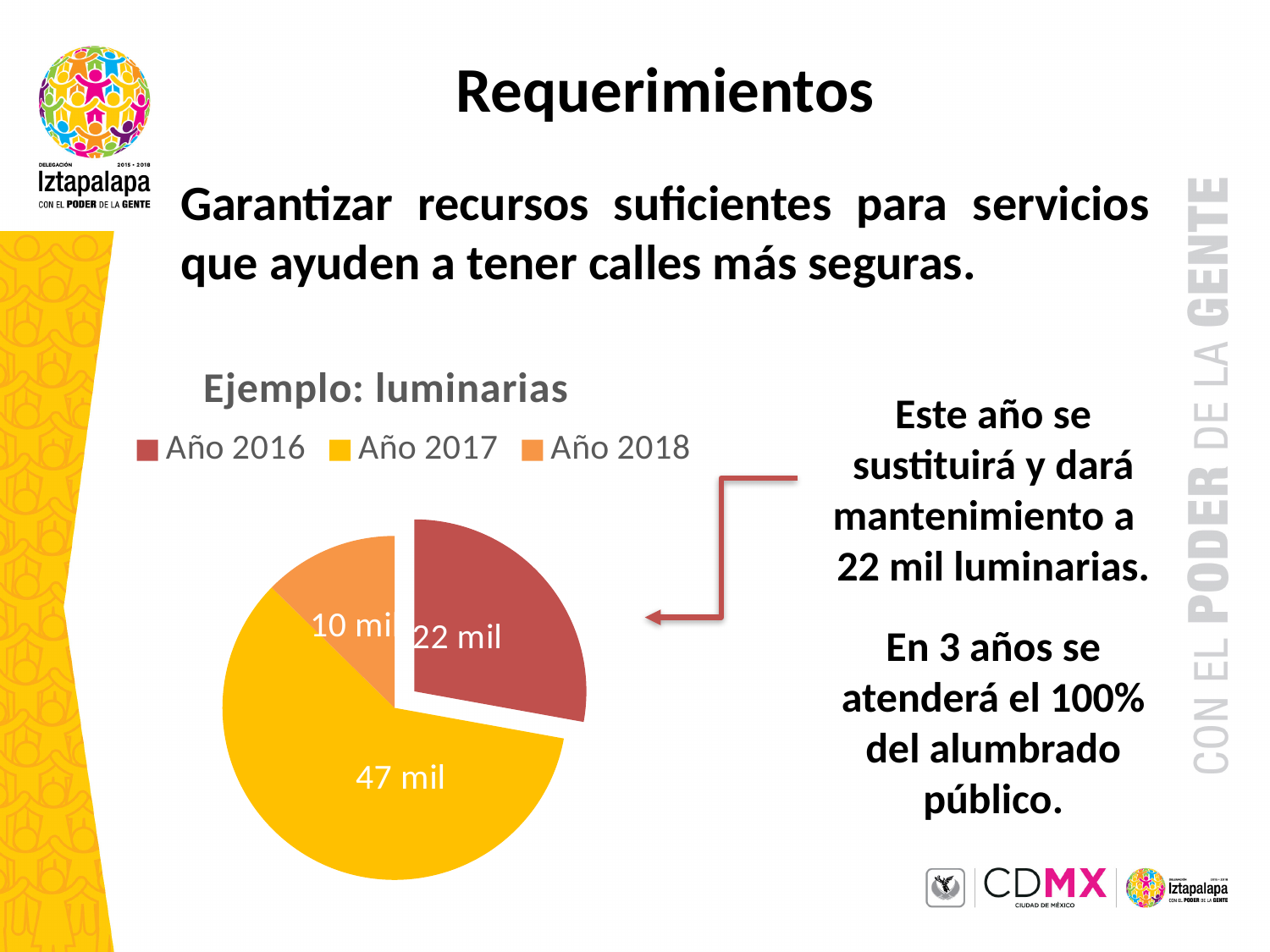
What is the value for Año 2017 in the pie chart? 47 mil What is the value for Año 2016 in the pie chart? 22 mil Which is larger, the value for Año 2016 or the value for Año 2018? Año 2016 What is the difference between the values for Año 2017 and Año 2016? 25 mil What is the difference between the values for Año 2016 and Año 2018? 12 mil Which year has the largest slice in the pie chart? Año 2017 How many slices does the pie chart have? 3 Which year has the smallest slice in the pie chart? Año 2018 What is the total of all three slices in the pie chart? 79 mil What type of chart is shown under the title "Ejemplo: luminarias"? pie chart What is the title of the pie chart? Ejemplo: luminarias What is the value for Año 2018 in the pie chart? 10 mil